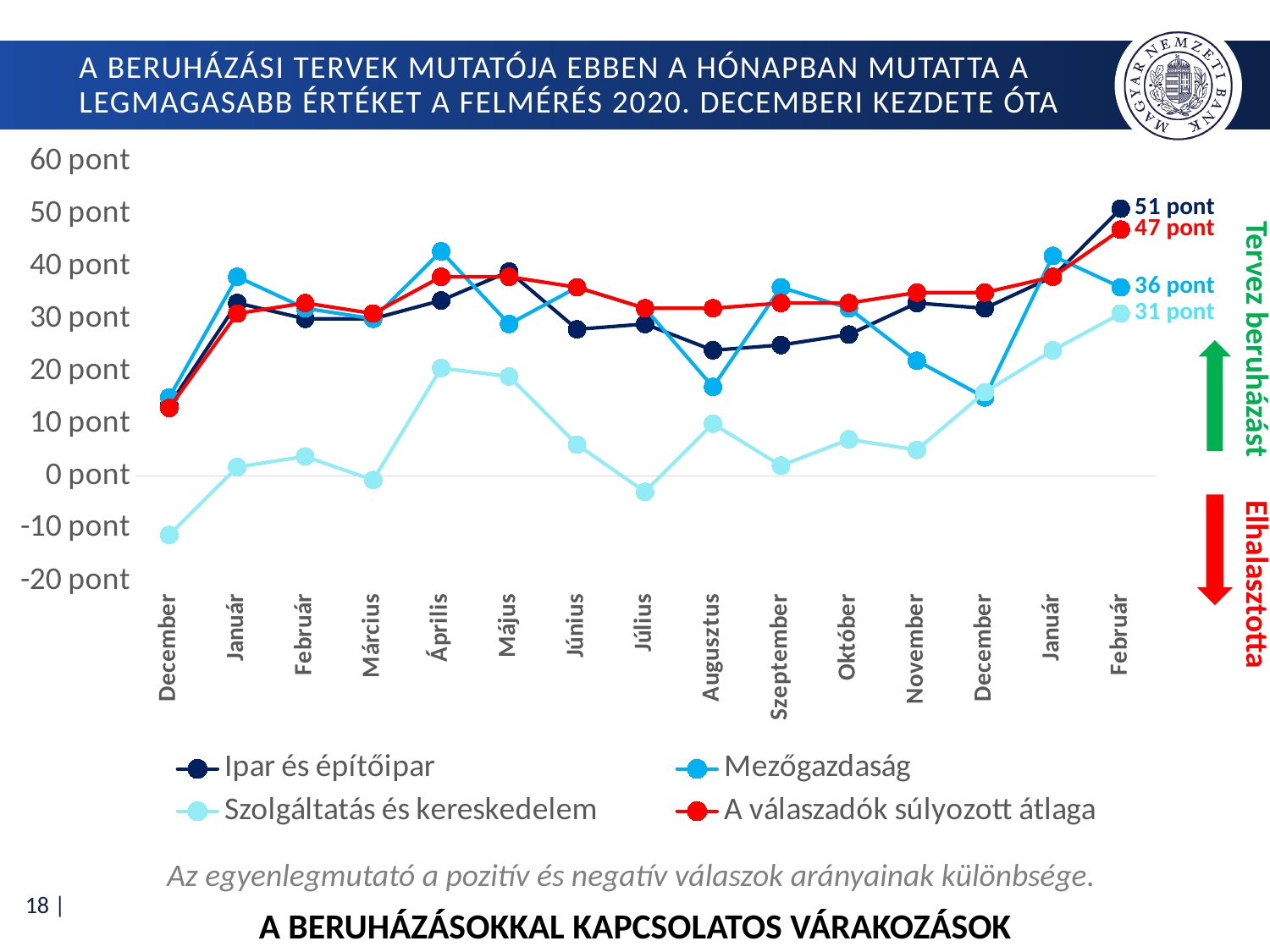
What is the difference between Ipar és építőipar and Szolgáltatás és kereskedelem in the final Február? 20 pont How many months are plotted along the x axis? 15 What is the value for Szolgáltatás és kereskedelem in the final Február? 31 pont What is the value for A válaszadók súlyozott átlaga in the final Február? 47 pont Is the value for Szolgáltatás és kereskedelem in the first December greater or less than 0 pont? less Which series has the highest value in the final Február? Ipar és építőipar Which series is drawn in red? A válaszadók súlyozott átlaga How many series does the legend list? 4 What is the value for Ipar és építőipar in the final Február? 51 pont What type of chart is shown on the slide? line chart What is the value for Mezőgazdaság in the final Február? 36 pont Which series has the lowest value in the final Február? Szolgáltatás és kereskedelem